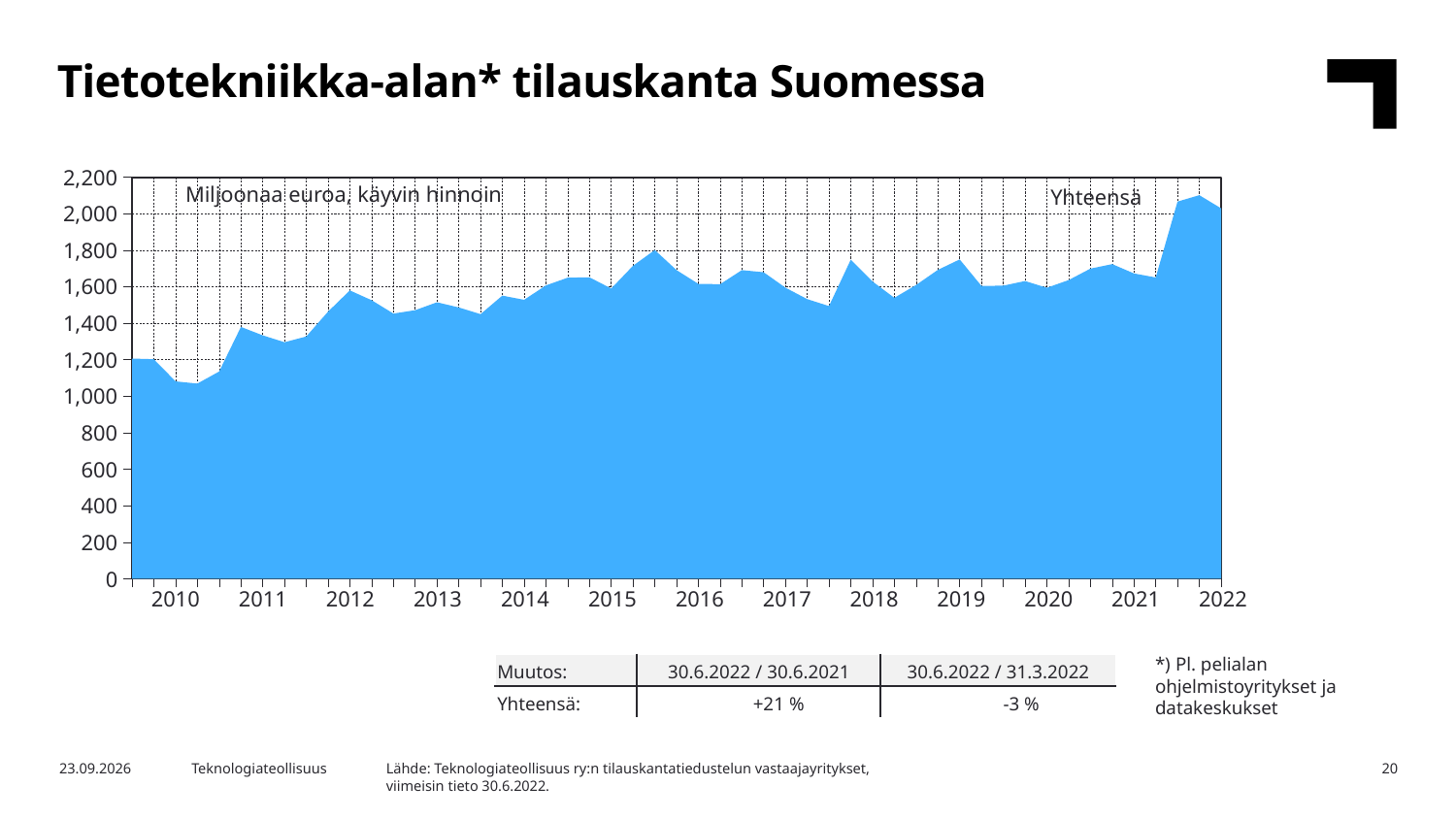
Is the lowest value in 2010 greater or less than 1,200? less Is the value at the end of 2021 larger than the value at the start of 2010? Yes, the end of 2021 is larger What kind of chart is shown on the slide? Area chart What is the title of the chart on the slide? Tietotekniikka-alan* tilauskanta Suomessa Is the peak value in 2015 greater or less than 1,600? greater How many year labels are shown on the x axis of the chart? 13 Is the value at the end of the series in 2022 greater or less than 1,800? greater Overall, do the values rise or fall from 2010 to 2022? Rise In which year does the chart show its lowest value? 2010 What is the highest value shown on the y axis of the chart? 2,200 In which year does the chart reach its highest value? 2022 What unit is the chart's data expressed in, according to the label inside the plot area? Miljoonaa euroa, käyvin hinnoin